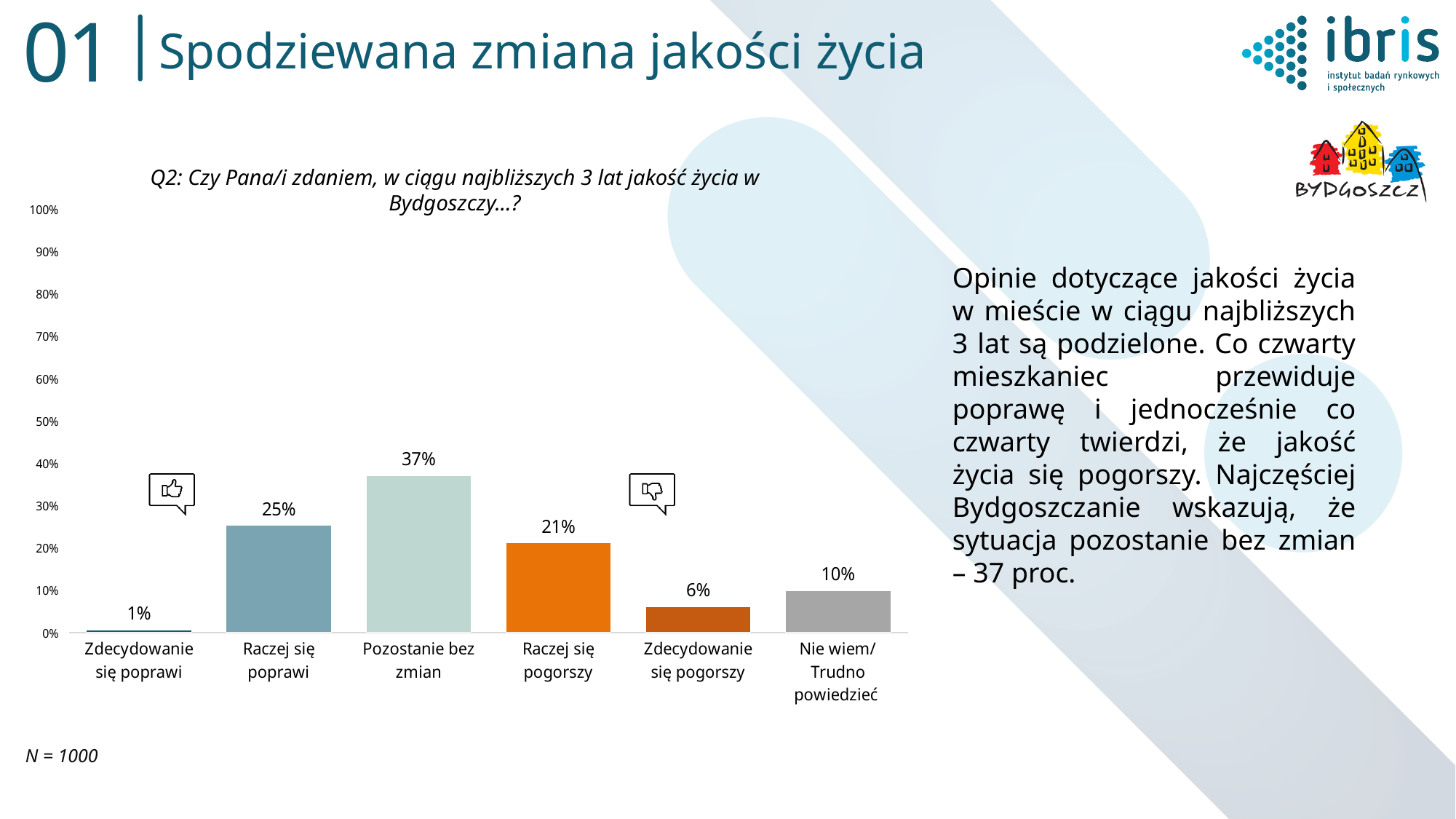
Which category has the highest value? Pozostanie bez zmian What is the difference between "Raczej się poprawi" and "Raczej się pogorszy"? 4 percentage points How many categories are shown on the x axis? 6 What is the value for "Zdecydowanie się pogorszy"? 6% What is the sample size (N) stated below the chart? N = 1000 What is the value for "Raczej się poprawi"? 25% Which category has the lowest value? Zdecydowanie się poprawi What is the value for "Pozostanie bez zmian"? 37% Is the value for "Pozostanie bez zmian" greater or less than 30%? greater What is the value for "Nie wiem/ Trudno powiedzieć"? 10% Which is larger, "Raczej się pogorszy" or "Nie wiem/ Trudno powiedzieć"? Raczej się pogorszy What kind of chart is shown on the slide? Bar chart